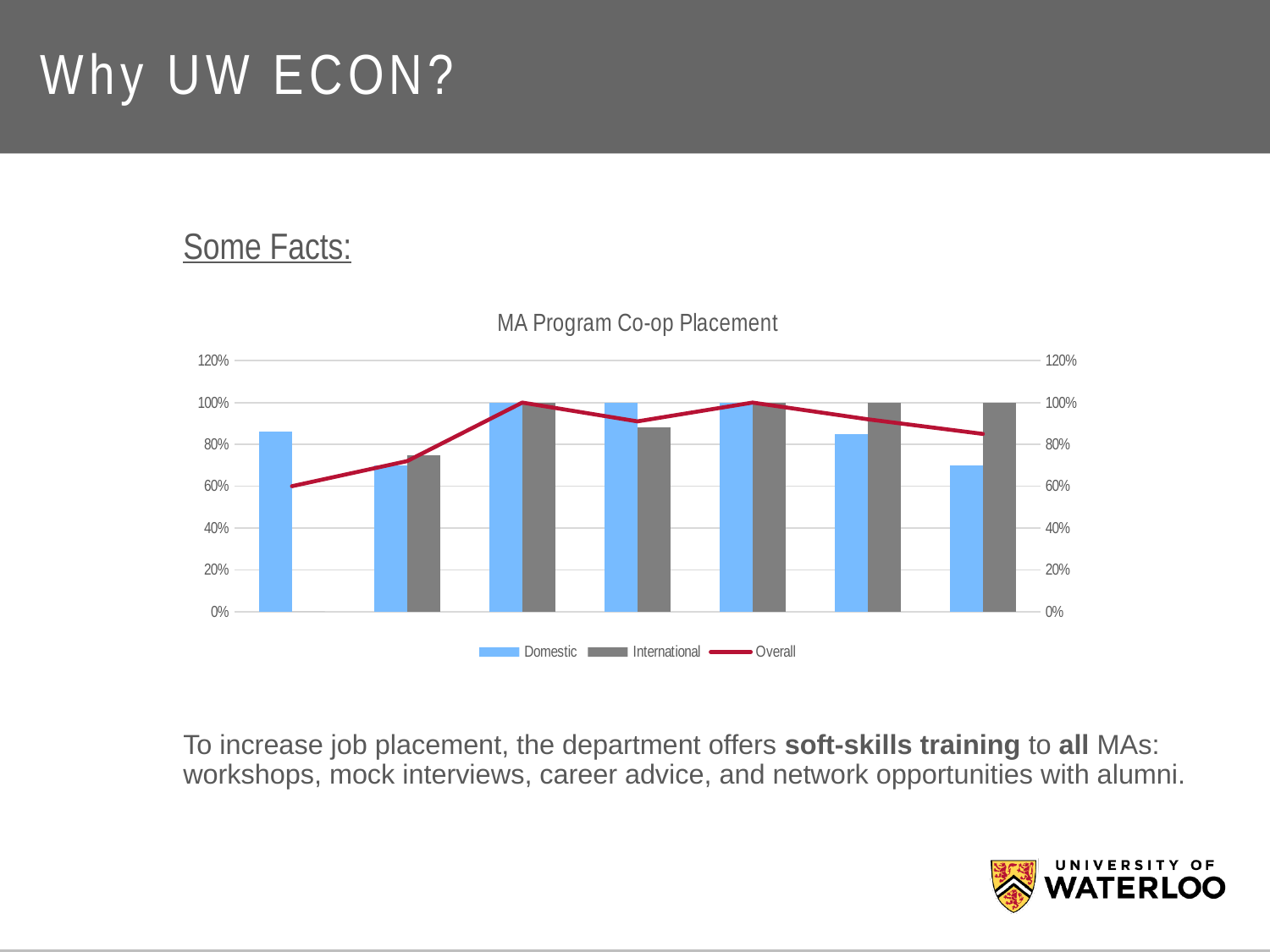
What kind of chart is shown under the title 'MA Program Co-op Placement'? A bar chart with a line In the 'MA Program Co-op Placement' chart, which is larger for the second group of bars from the left: the Domestic value or the International value? International In the 'MA Program Co-op Placement' chart, is the Overall value for the leftmost group greater or less than 80%? less How many series does the legend of the 'MA Program Co-op Placement' chart list? 3 In the 'MA Program Co-op Placement' chart, what is the Domestic value for the third group of bars from the left? 100% In the 'MA Program Co-op Placement' chart, is the Domestic value for the leftmost group of bars greater or less than 80%? greater Which series in the 'MA Program Co-op Placement' chart is drawn as a red line? Overall In the 'MA Program Co-op Placement' chart, which is larger for the rightmost group of bars: the Domestic value or the International value? International In the 'MA Program Co-op Placement' chart, is the Domestic value for the rightmost group of bars greater or less than 80%? less What is the title of the chart on the slide? MA Program Co-op Placement In the 'MA Program Co-op Placement' chart, what is the International value for the rightmost group of bars? 100% How many groups of bars are plotted along the x axis of the 'MA Program Co-op Placement' chart? 7